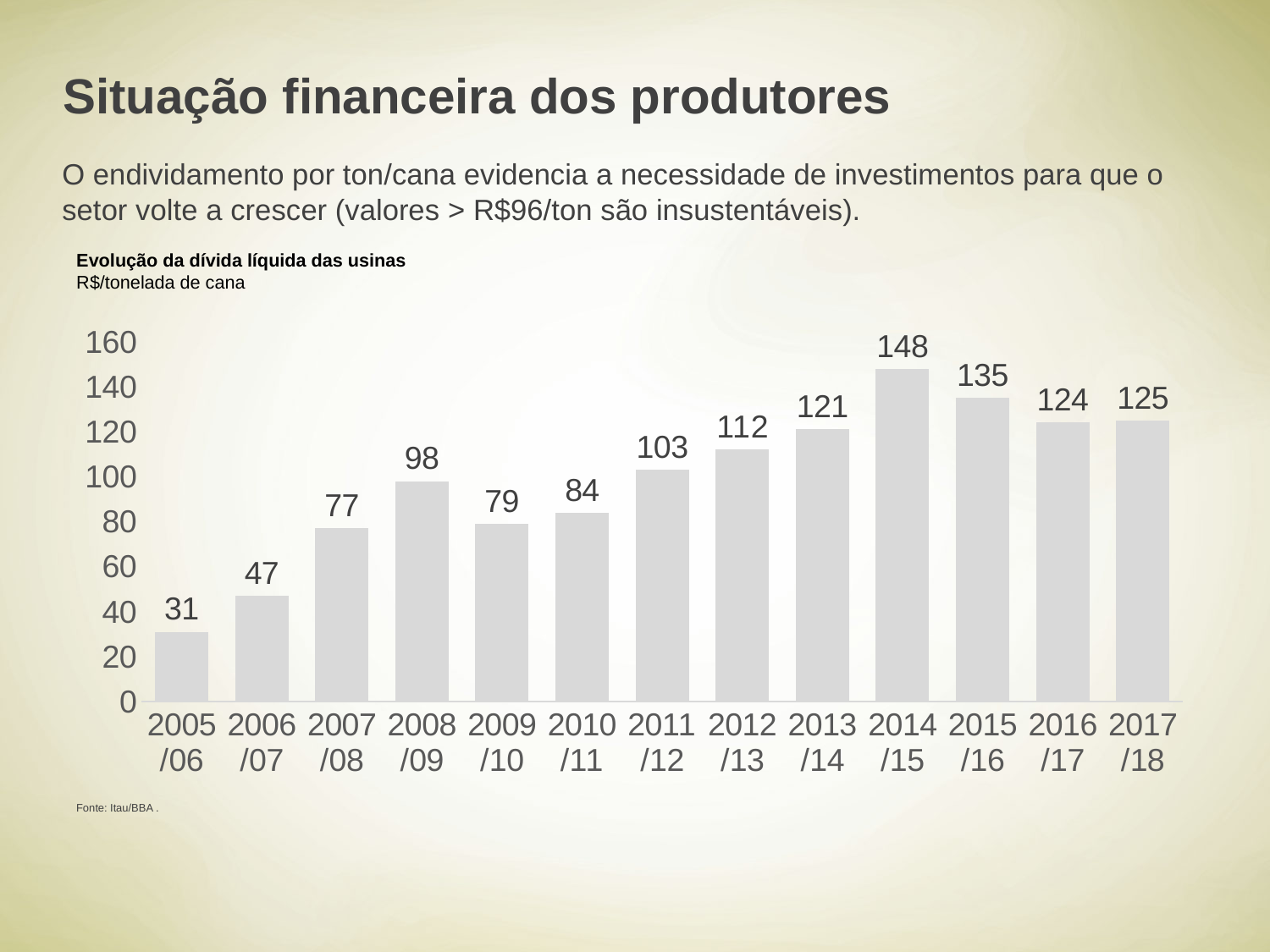
Is the value for 2012/13 greater or less than 100? greater What is the difference between the values for 2014/15 and 2015/16? 13 What is the value for 2005/06? 31 How many seasons are shown on the x axis? 13 What kind of chart is shown on the slide? bar chart Which is larger, the value for 2016/17 or the value for 2017/18? 2017/18 What is the difference between the values for 2008/09 and 2009/10? 19 What is the value for 2014/15? 148 What is the value for 2011/12? 103 What unit is given under the chart title? R$/tonelada de cana Which season has the lowest value? 2005/06 Which season has the highest value? 2014/15